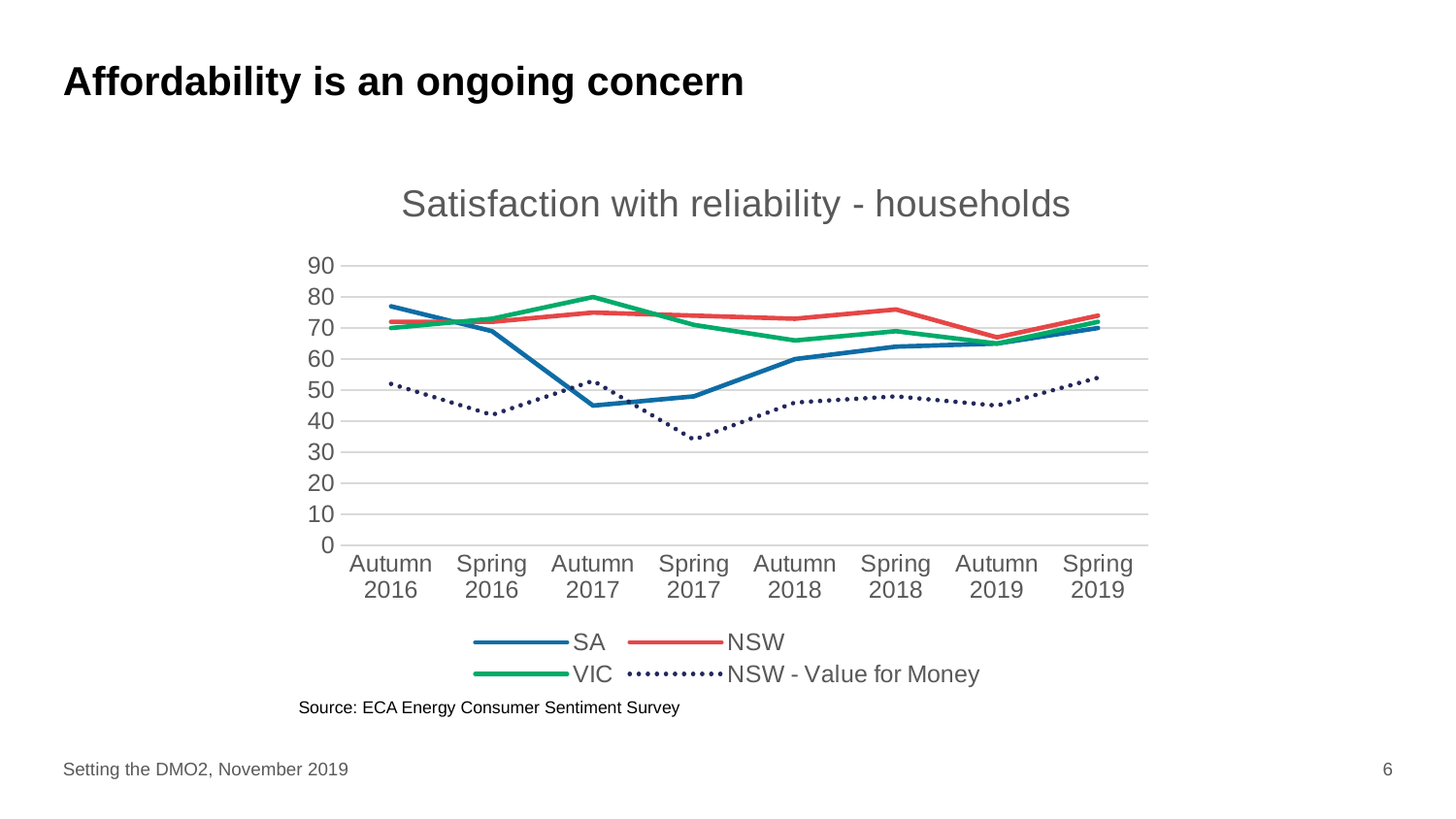
In which period does the VIC series reach its highest value? Autumn 2017 Is the value for NSW in Spring 2018 greater or less than 70? greater How many time periods are shown along the x axis? 8 How many series does the legend list? 4 What kind of chart is shown on the slide? line chart Is the value for SA in Autumn 2017 greater or less than 50? less Which series is drawn with a dotted line? NSW - Value for Money In Autumn 2017, which is larger, the value for SA or the value for VIC? VIC Is the value for VIC in Autumn 2017 greater or less than 70? greater In which period does the NSW - Value for Money series reach its lowest value? Spring 2017 What is the title of the chart? Satisfaction with reliability - households